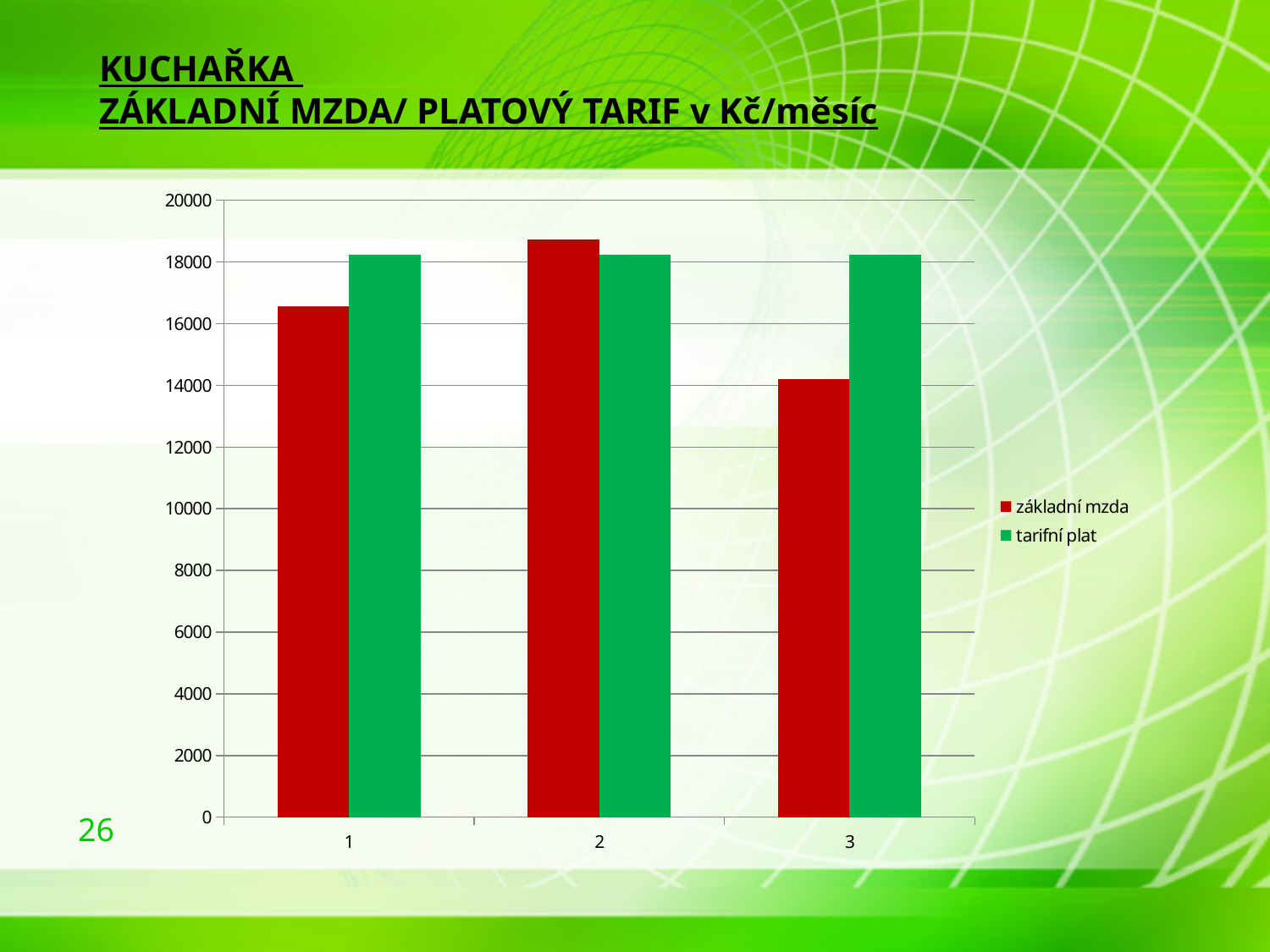
How many categories are shown on the x axis? 3 For which category is the základní mzda bar the lowest? 3 How many series does the legend list? 2 Which colour represents the tarifní plat series in the legend? green What kind of chart is shown on the slide? bar chart For which category is the základní mzda bar the highest? 2 Is the základní mzda value for category 2 greater or less than 18000? greater In category 2, which is larger: základní mzda or tarifní plat? základní mzda Is the základní mzda value for category 1 greater or less than 16000? greater In category 1, which is larger: základní mzda or tarifní plat? tarifní plat Is the základní mzda value for category 3 greater or less than 16000? less In category 3, which is larger: základní mzda or tarifní plat? tarifní plat